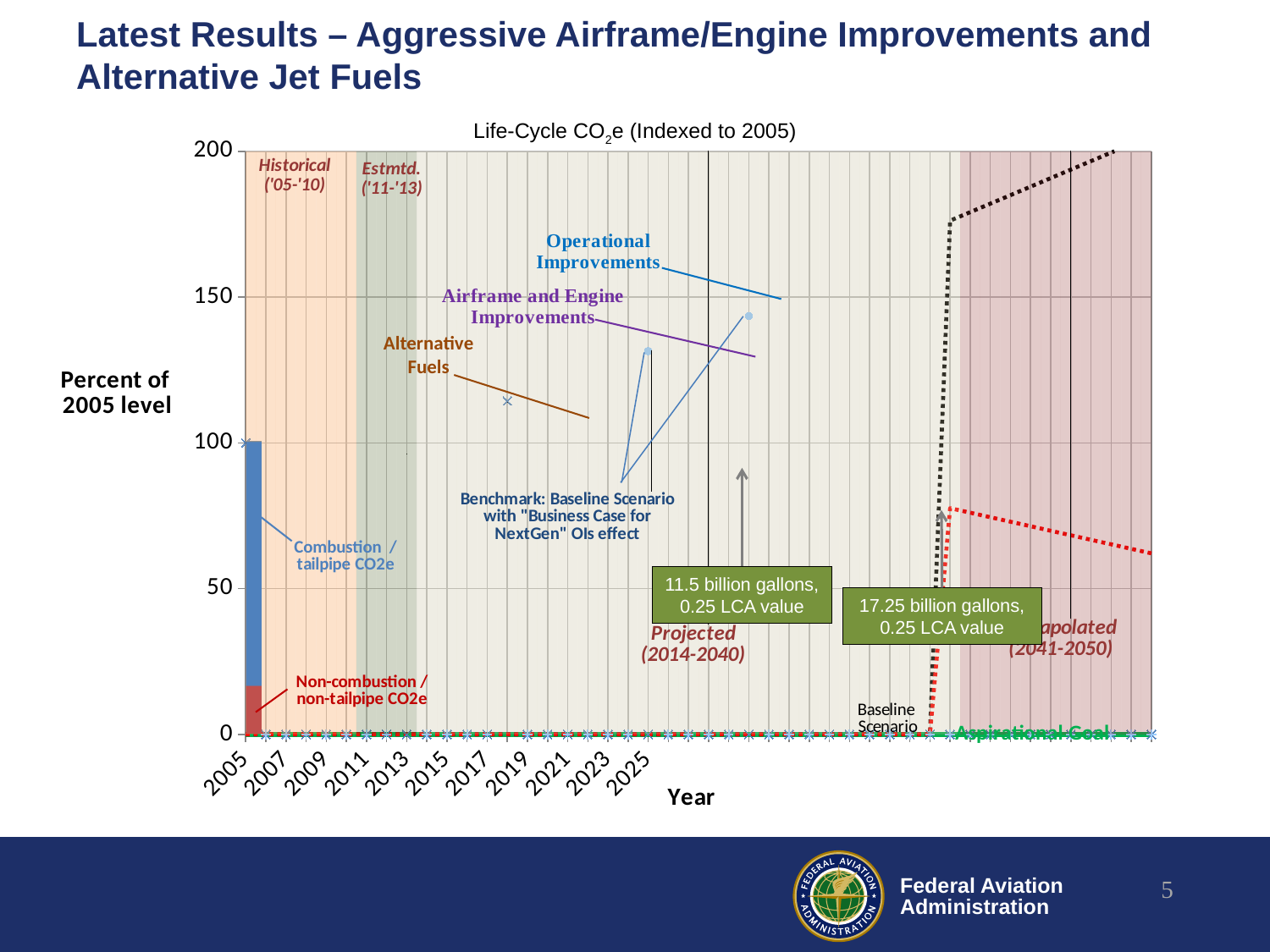
What is the title of the chart? Life-Cycle CO2e (Indexed to 2005) How many billion gallons are stated in the green callout that reads '0.25 LCA value' on the right side of the chart? 17.25 billion gallons Is the Non-combustion / non-tailpipe CO2e portion of the 2005 bar greater or less than 50? less Is the Combustion / tailpipe CO2e portion of the 2005 bar greater or less than 50? greater How many year labels are printed along the horizontal axis? 11 Which years does the 'Projected' period cover according to the chart annotation? 2014-2040 In the Extrapolated (2041-2050) region, does the red dotted line rise or fall from left to right? fall What is the highest value shown on the vertical axis? 200 What is the label on the vertical axis of the chart? Percent of 2005 level What value does the top of the stacked bar for 2005 reach on the vertical axis? 100